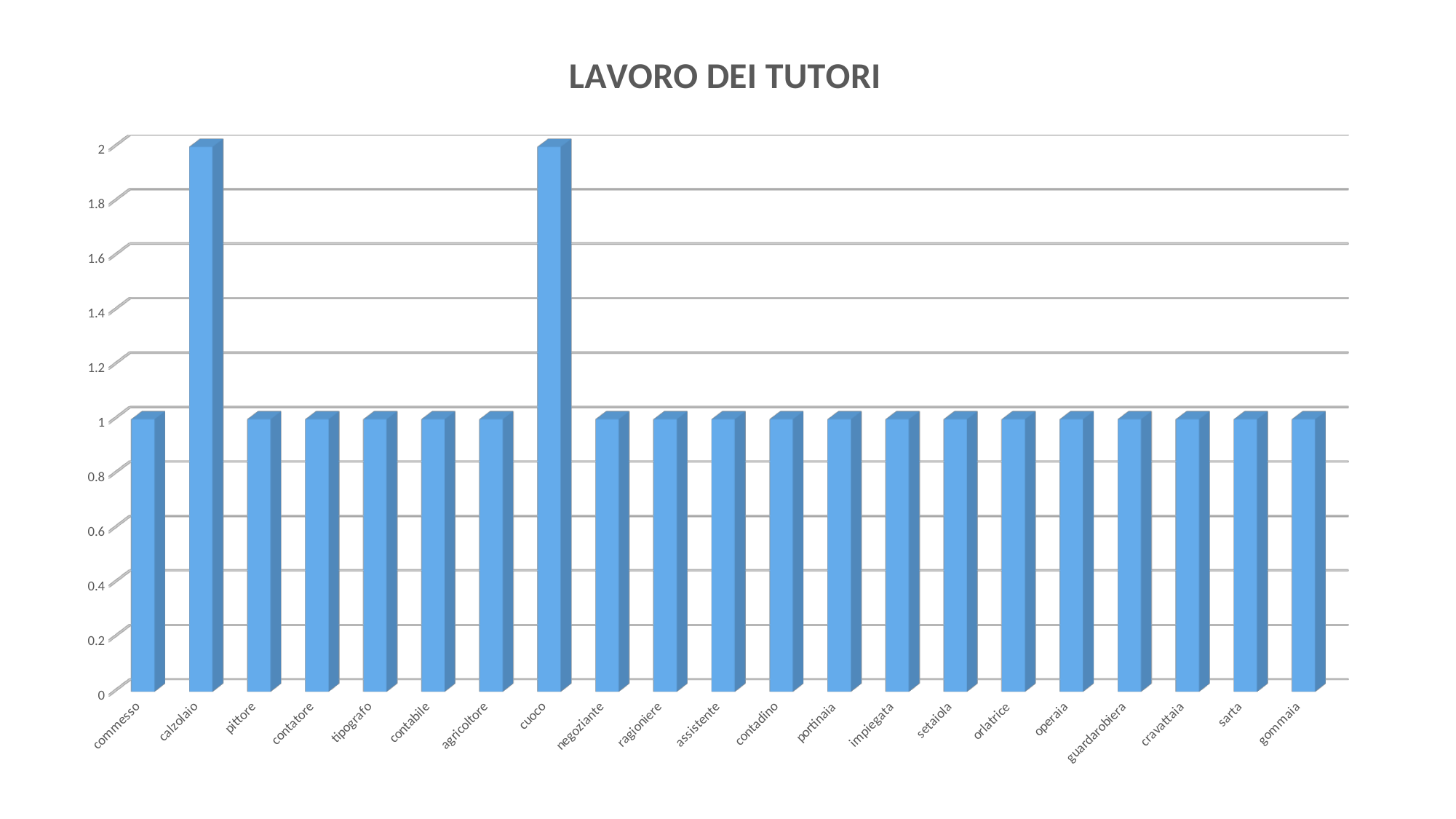
What kind of chart is shown on the slide? bar chart What is the value for cuoco? 2 Is the value for cuoco greater or less than 1.5? greater What is the difference between the values for calzolaio and pittore? 1 What is the value for calzolaio? 2 How many categories are shown on the x axis? 21 What is the value for commesso? 1 Is the value for sarta greater or less than 1.5? less Which is larger, the value for cuoco or the value for negoziante? cuoco What is the title of the chart? LAVORO DEI TUTORI Which categories have the highest value? calzolaio and cuoco What is the value for gommaia? 1